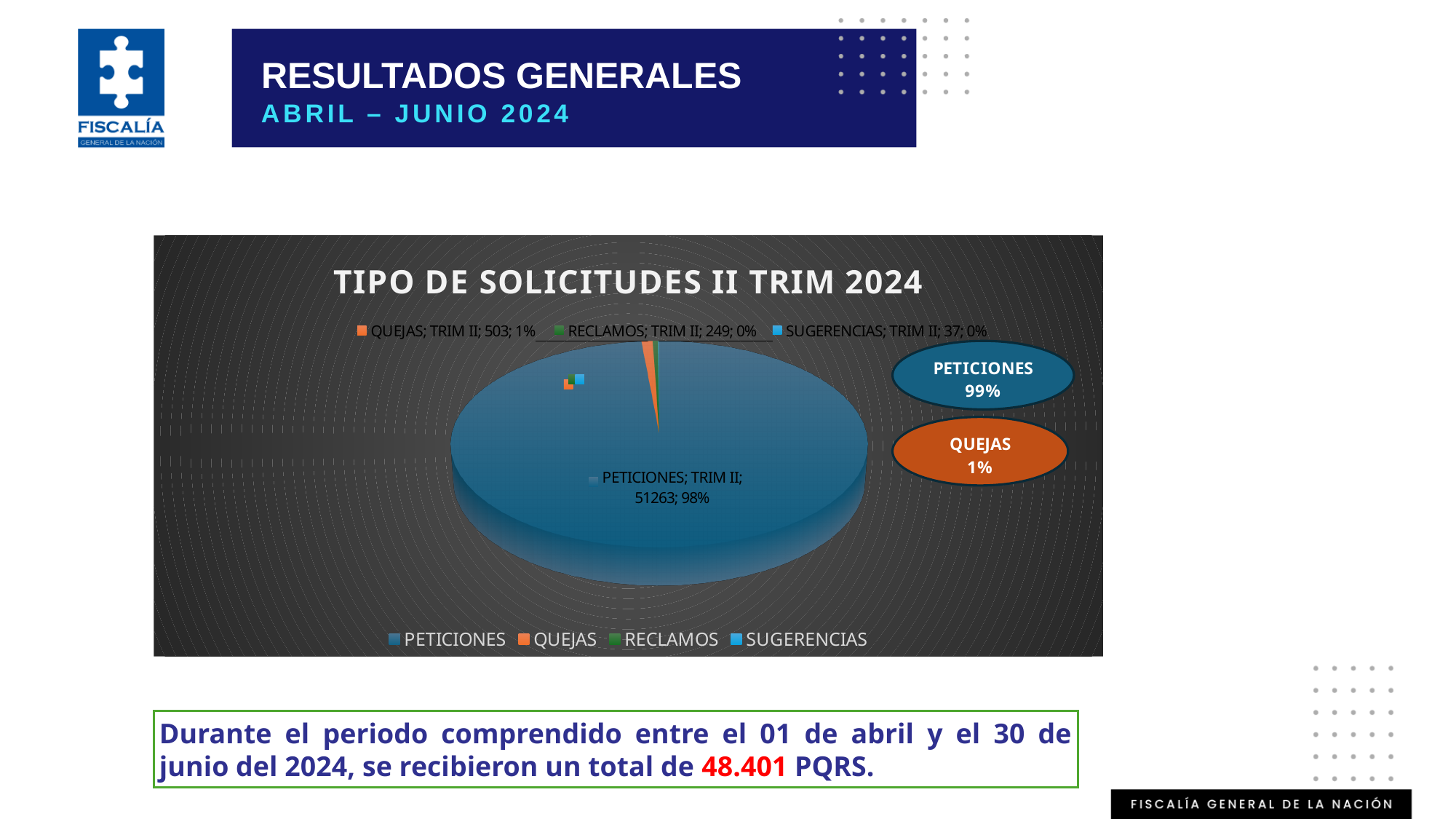
How many categories does the pie chart show? 4 What is the value shown for PETICIONES in the pie chart? 51263 What is the value shown for SUGERENCIAS in the pie chart? 37 Which category has the smallest value in the pie chart? SUGERENCIAS What percentage share of the pie does QUEJAS have according to its data label? 1% What percentage share of the pie does PETICIONES have according to its data label? 98% What is the value shown for QUEJAS in the pie chart? 503 What kind of chart is shown on the slide? pie chart What is the value shown for RECLAMOS in the pie chart? 249 Which category has the largest slice in the pie chart? PETICIONES What is the difference between the values for QUEJAS and RECLAMOS? 254 What is the title of the chart? TIPO DE SOLICITUDES II TRIM 2024